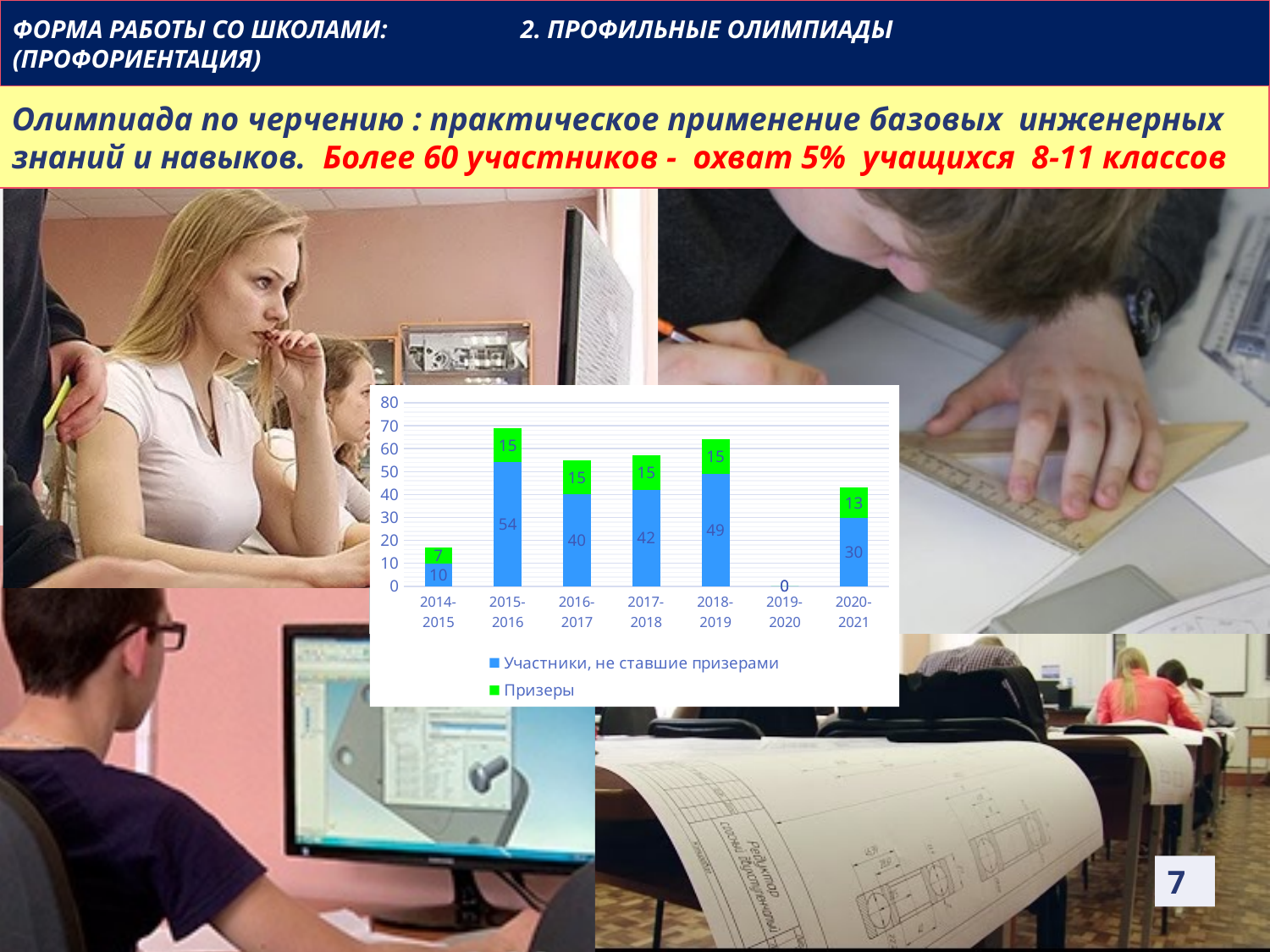
What value is shown for 2019-2020 in the chart? 0 What type of chart is shown on the slide? stacked bar chart Which academic year has the lowest value for 'Призеры' among years with a non-zero bar? 2014-2015 Which is larger: 'Участники, не ставшие призерами' in 2017-2018 or in 2020-2021? 2017-2018 What is the value of 'Призеры' for 2020-2021? 13 How many series does the chart legend list? 2 What is the difference between 'Участники, не ставшие призерами' in 2015-2016 and in 2016-2017? 14 Which academic year has the highest value for 'Участники, не ставшие призерами'? 2015-2016 What is the value of 'Участники, не ставшие призерами' for 2014-2015? 10 How many academic-year categories are shown on the x axis of the chart? 7 What is the total height of the stacked bar for 2018-2019? 64 What is the value of 'Участники, не ставшие призерами' for 2015-2016? 54